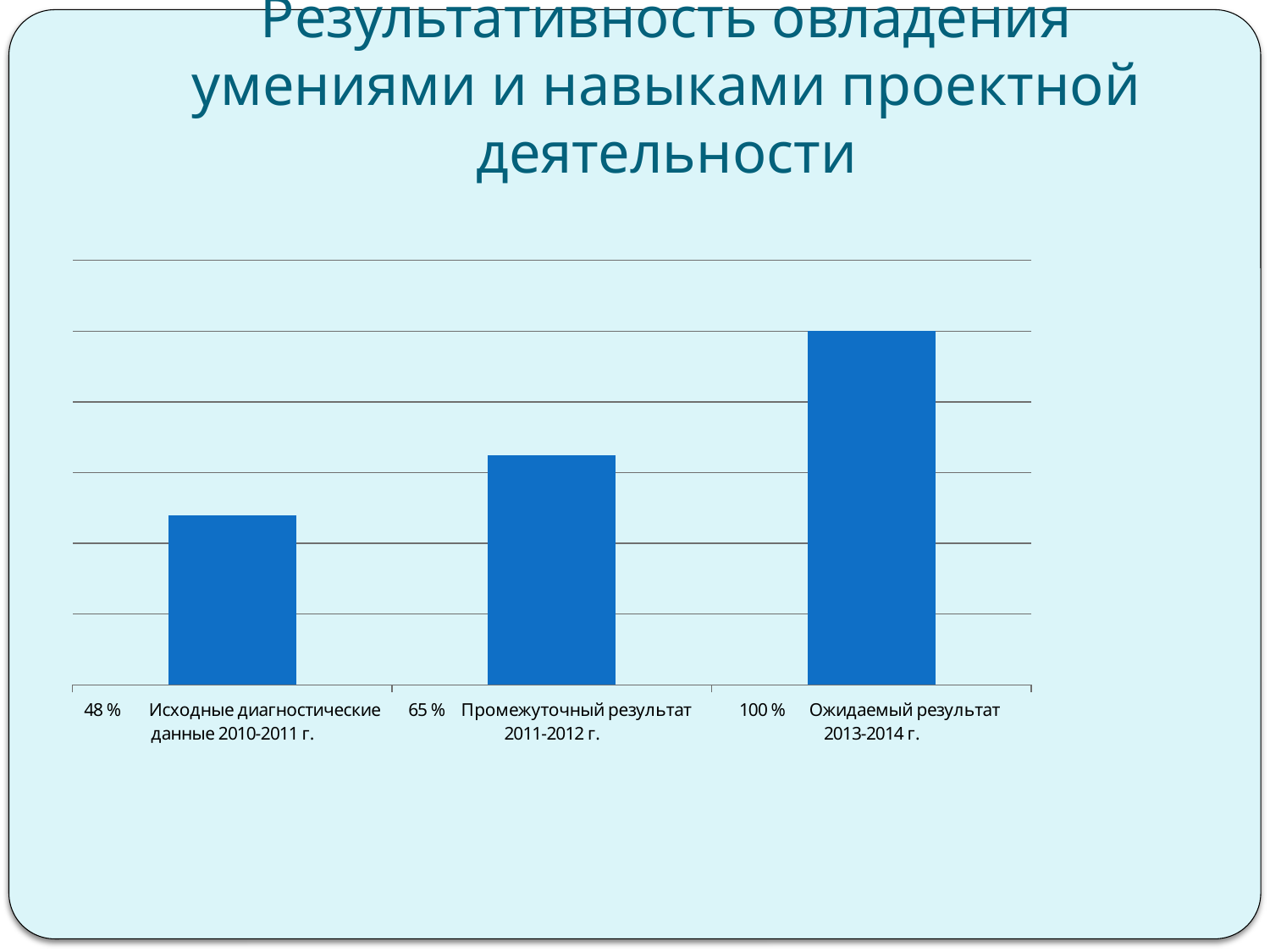
What is the difference between the value for "Ожидаемый результат 2013-2014 г." and the value for "Исходные диагностические данные 2010-2011 г."? 52 % How many bars (categories) does the chart show? 3 Which category has the highest value? Ожидаемый результат 2013-2014 г. What value is shown for "Ожидаемый результат 2013-2014 г."? 100 % What value is shown for "Исходные диагностические данные 2010-2011 г."? 48 % Which is larger: the value for "Промежуточный результат 2011-2012 г." or the value for "Ожидаемый результат 2013-2014 г."? Ожидаемый результат 2013-2014 г. Do the values rise or fall from left to right across the categories? Rise What type of chart is shown on the slide? Bar chart What is the title of the slide containing the chart? Результативность овладения умениями и навыками проектной деятельности Which category has the lowest value? Исходные диагностические данные 2010-2011 г. What value is shown for "Промежуточный результат 2011-2012 г."? 65 % What is the difference between the value for "Промежуточный результат 2011-2012 г." and the value for "Исходные диагностические данные 2010-2011 г."? 17 %